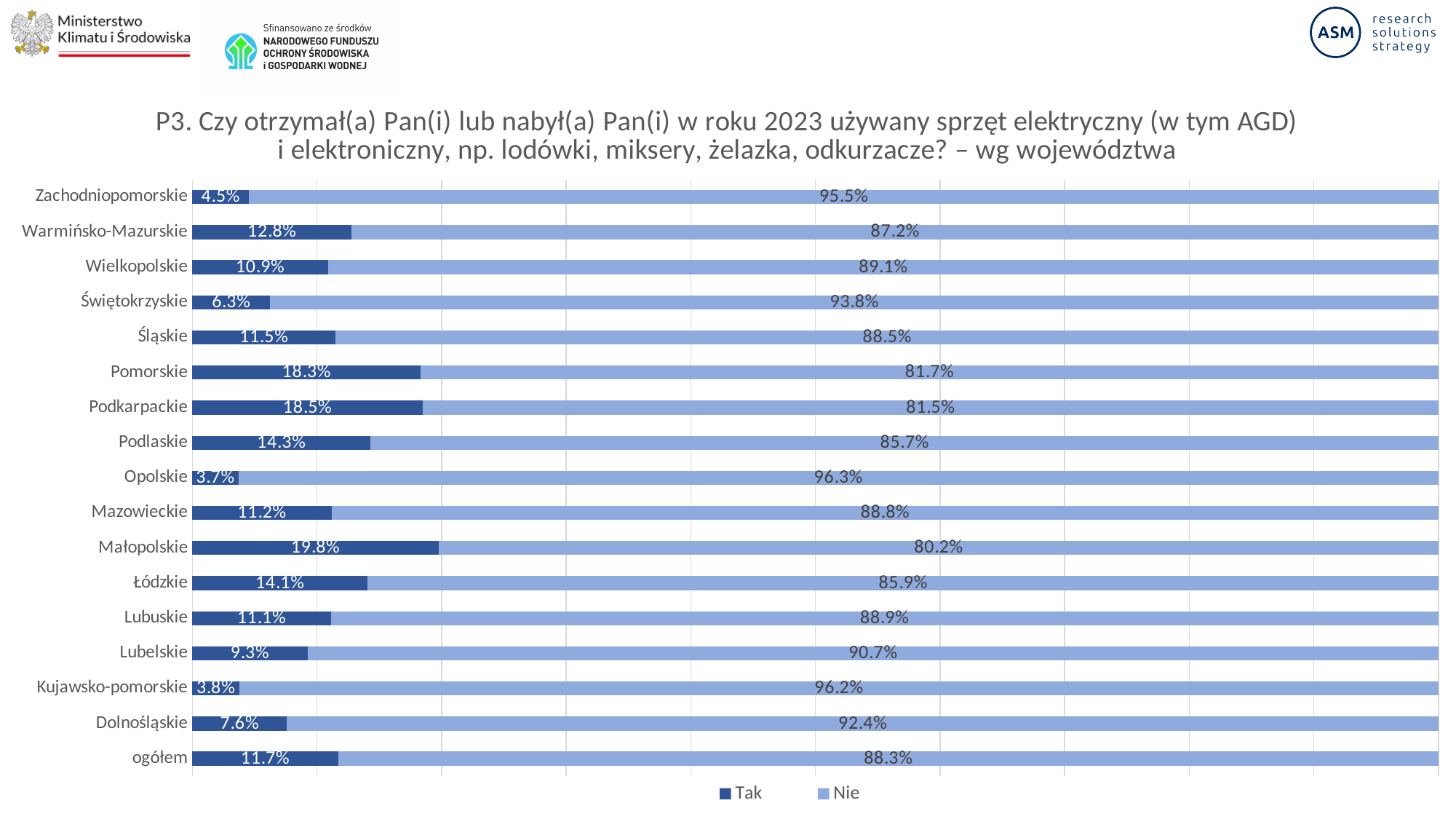
What percentage of respondents in Małopolskie answered "Tak"? 19.8% Which voivodeship has the highest "Tak" share? Małopolskie How many categories (rows) are shown on the chart? 17 What is the "Nie" value for Świętokrzyskie? 93.8% What is the difference in percentage points between the "Tak" value for Małopolskie and the "Tak" value for ogółem? 8.1 percentage points Which has a larger "Tak" value: Pomorskie or Podkarpackie? Podkarpackie What is the "Tak" value for the "ogółem" (overall) row? 11.7% What kind of chart is shown on the slide? Stacked horizontal bar chart Which voivodeship has the lowest "Tak" share? Opolskie What is the total of the stacked bar for Zachodniopomorskie? 100% Which has a larger "Nie" value: Lubelskie or Dolnośląskie? Dolnośląskie How many series does the legend list? 2